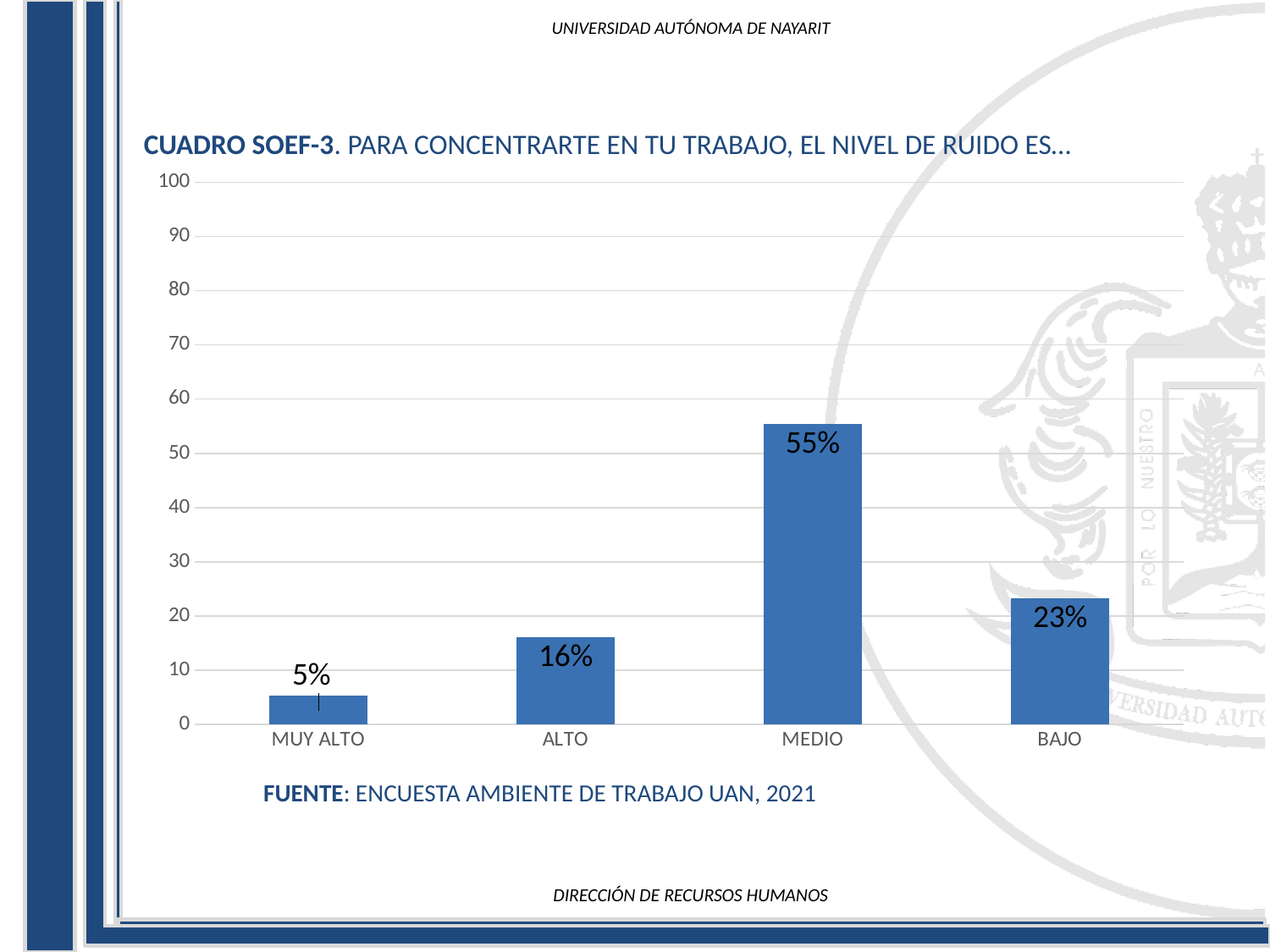
Is the value for MEDIO greater or less than 50? greater What is the value for BAJO? 23% What is the value for MEDIO? 55% Which is larger, the value for ALTO or the value for BAJO? BAJO What source is cited below the chart? ENCUESTA AMBIENTE DE TRABAJO UAN, 2021 What is the value for ALTO? 16% What is the value for MUY ALTO? 5% What kind of chart is shown on the slide? bar chart How many categories are shown on the x axis? 4 Which category has the highest value? MEDIO Which category has the lowest value? MUY ALTO What is the difference between the values for MEDIO and BAJO? 32%